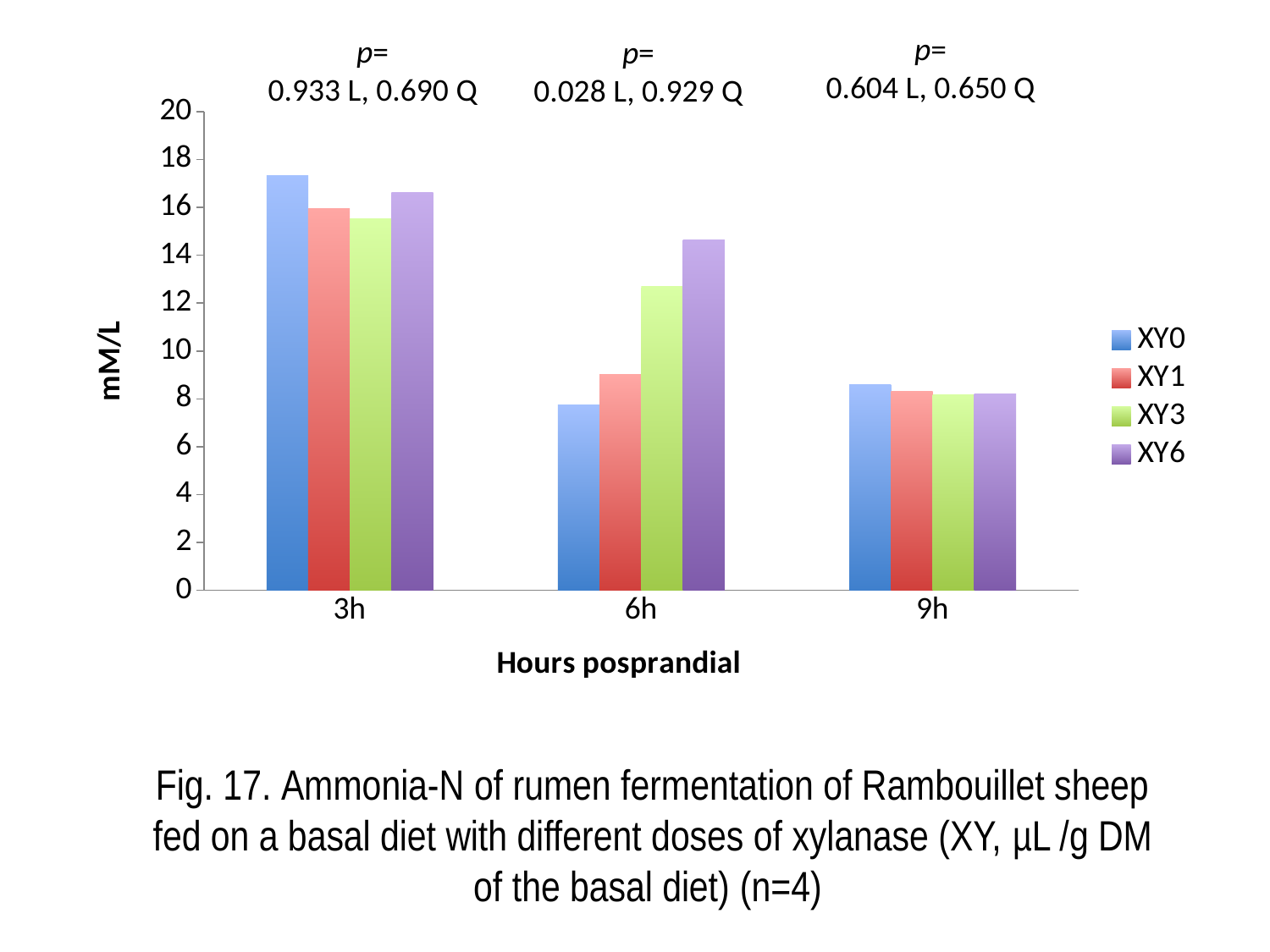
At 6h, which series has the highest value? XY6 Is the value for XY1 at 9h greater or less than 10? less Is the value for XY0 at 3h greater or less than 16? greater At 6h, which is larger: XY3 or XY1? XY3 Does the value for XY6 rise or fall from 3h to 9h? fall What is the label on the y axis? mM/L Is the value for XY6 at 6h greater or less than 14? greater At 6h, which series has the lowest value? XY0 What kind of chart is shown on the slide? bar chart How many series does the legend list? 4 How many time-point categories are shown on the x axis? 3